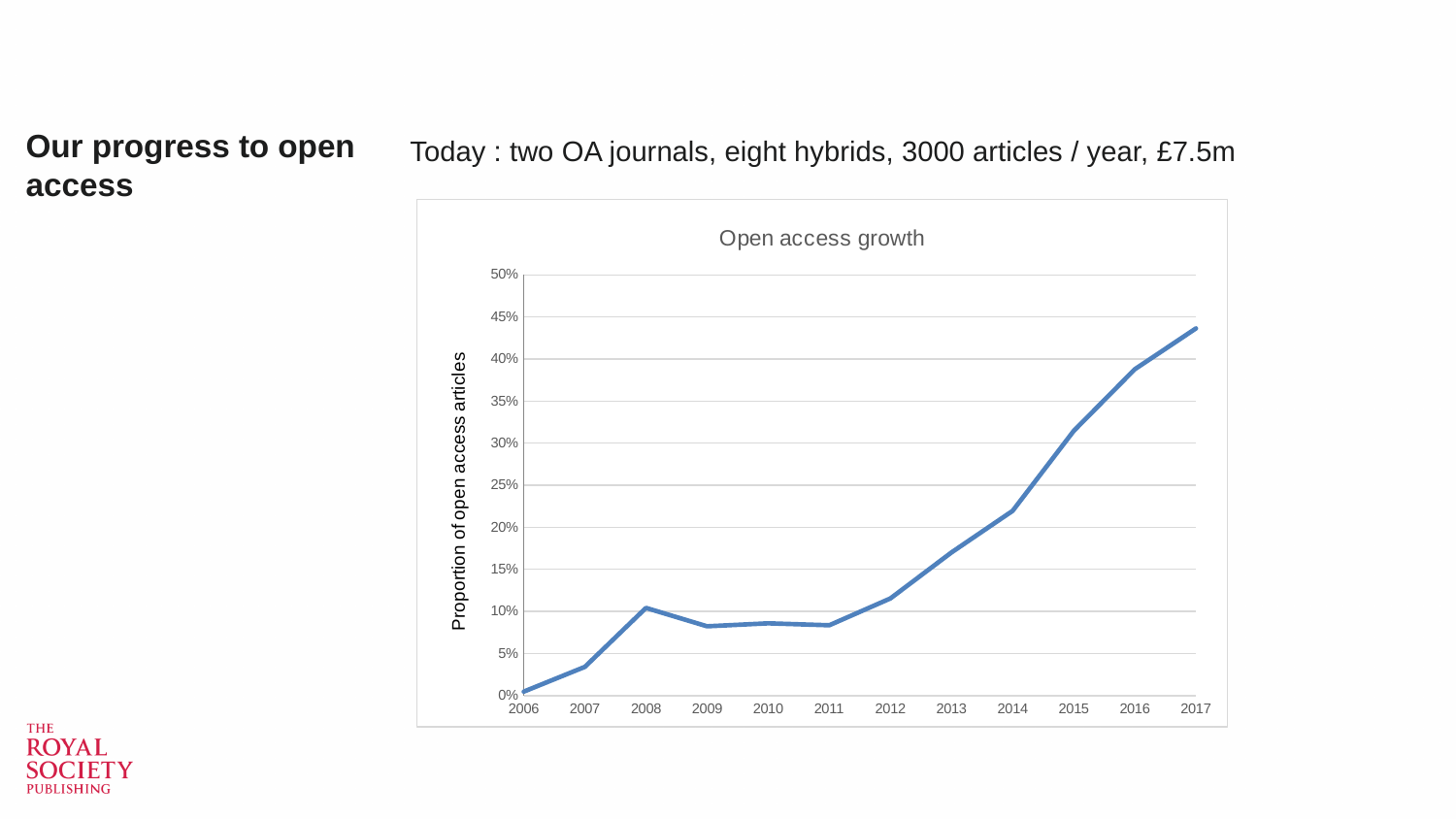
Which year has the larger proportion of open access articles, 2008 or 2009? 2008 Is the value for 2007 greater or less than 5%? less Is the value for 2013 greater or less than 20%? less What is the title of the chart? Open access growth What is the label on the vertical axis of the chart? Proportion of open access articles Overall, do the values rise or fall from 2006 to 2017? rise Which year has the lowest proportion of open access articles? 2006 How many years are plotted along the x axis of the chart? 12 Is the value for 2017 greater or less than 40%? greater Which year has the highest proportion of open access articles? 2017 What kind of chart is shown on the slide? line chart